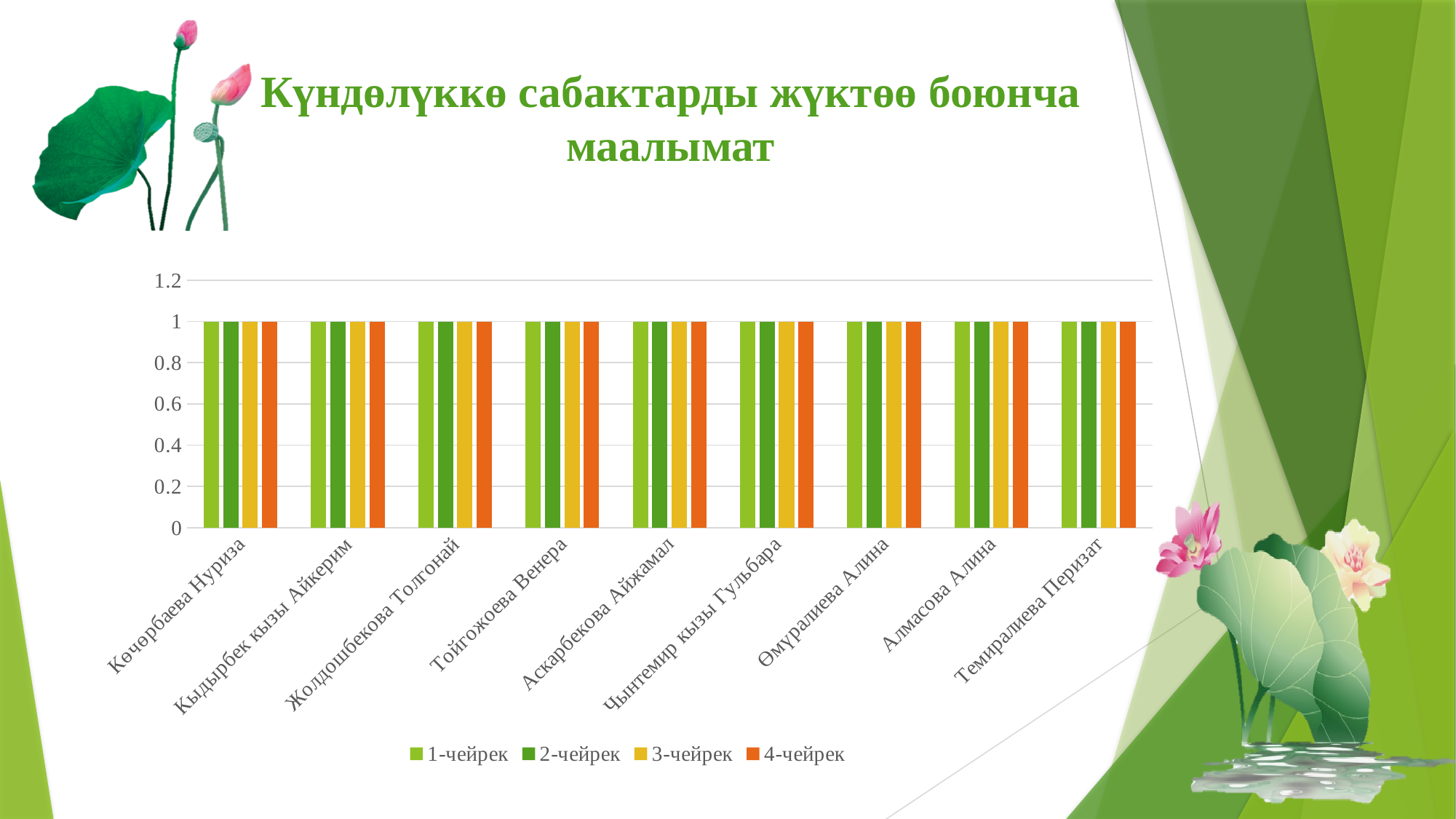
How many categories (students) are shown on the x axis of the chart? 9 What is the value for Көчөрбаева Нуриза in the 1-чейрек series? 1 What kind of chart is shown on the slide? bar chart How many series does the chart's legend list? 4 Is the value for Алмасова Алина in the 2-чейрек series greater or less than 0.8? greater Is the value for Аскарбекова Айжамал in the 4-чейрек series greater or less than 1.2? less What is the value for Темиралиева Перизат in the 4-чейрек series? 1 Do the 1-чейрек values rise, fall, or stay flat across the categories along the x axis? stay flat What is the difference between the 1-чейрек value for Кыдырбек кызы Айкерим and the 1-чейрек value for Өмүралиева Алина? 0 Which legend entry is shown in orange? 4-чейрек What is the value for Тойгожоева Венера in the 3-чейрек series? 1 What is the title of the chart on the slide? Күндөлүккө сабактарды жүктөө боюнча маалымат